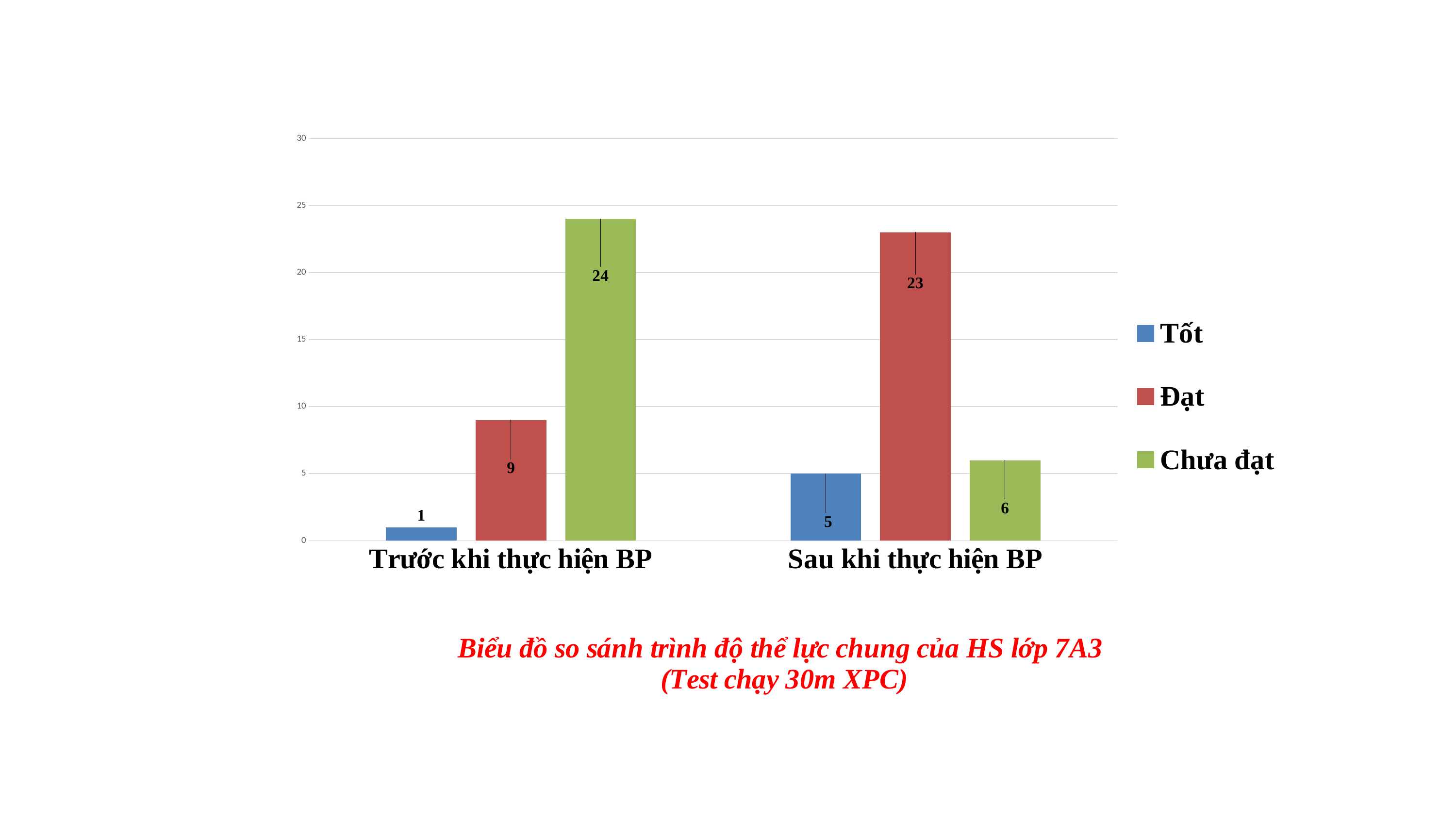
Which series has the lowest value in the 'Sau khi thực hiện BP' category? Tốt What is the value for Tốt in the 'Trước khi thực hiện BP' category? 1 Which is larger: Đạt before implementing BP or Đạt after implementing BP? Sau khi thực hiện BP Which series has the highest value in the 'Trước khi thực hiện BP' category? Chưa đạt Is the value for Chưa đạt in 'Trước khi thực hiện BP' greater or less than 20? greater What is the difference between the Chưa đạt values before and after implementing BP? 18 What is the value for Chưa đạt in the 'Sau khi thực hiện BP' category? 6 What kind of chart is shown on the slide? Bar chart What is the value for Đạt in the 'Sau khi thực hiện BP' category? 23 How many categories are shown on the x axis? 2 What colour represents the Đạt series? Red How many series does the legend list? 3